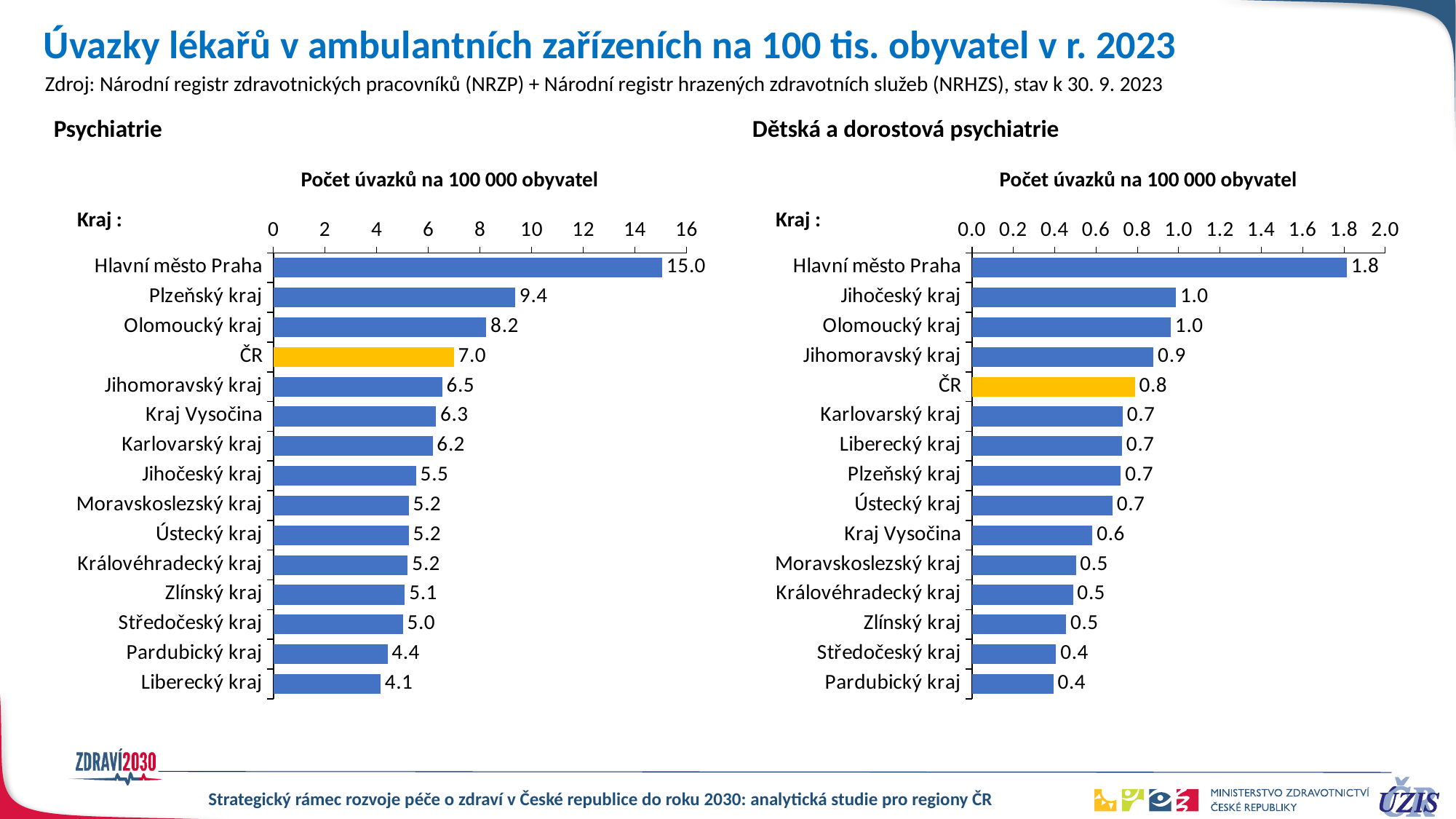
In the Dětská a dorostová psychiatrie chart, what is the value for ČR? 0.8 How many bars are shown in the Psychiatrie chart? 15 In the Dětská a dorostová psychiatrie chart, what is the difference between Hlavní město Praha and Jihočeský kraj? 0.8 In the Dětská a dorostová psychiatrie chart, which region has the highest value? Hlavní město Praha In the Psychiatrie chart, what is the difference between Plzeňský kraj and Olomoucký kraj? 1.2 What type of chart is the Dětská a dorostová psychiatrie chart? Bar chart In the Psychiatrie chart, which region has the lowest value? Liberecký kraj In the Psychiatrie chart, which bar is coloured differently (yellow) from the others? ČR In the Psychiatrie chart, which is larger, Jihomoravský kraj or Jihočeský kraj? Jihomoravský kraj In the Dětská a dorostová psychiatrie chart, what is the value for Hlavní město Praha? 1.8 In the Psychiatrie chart, what is the value for Hlavní město Praha? 15.0 In the Psychiatrie chart, what is the value for ČR? 7.0